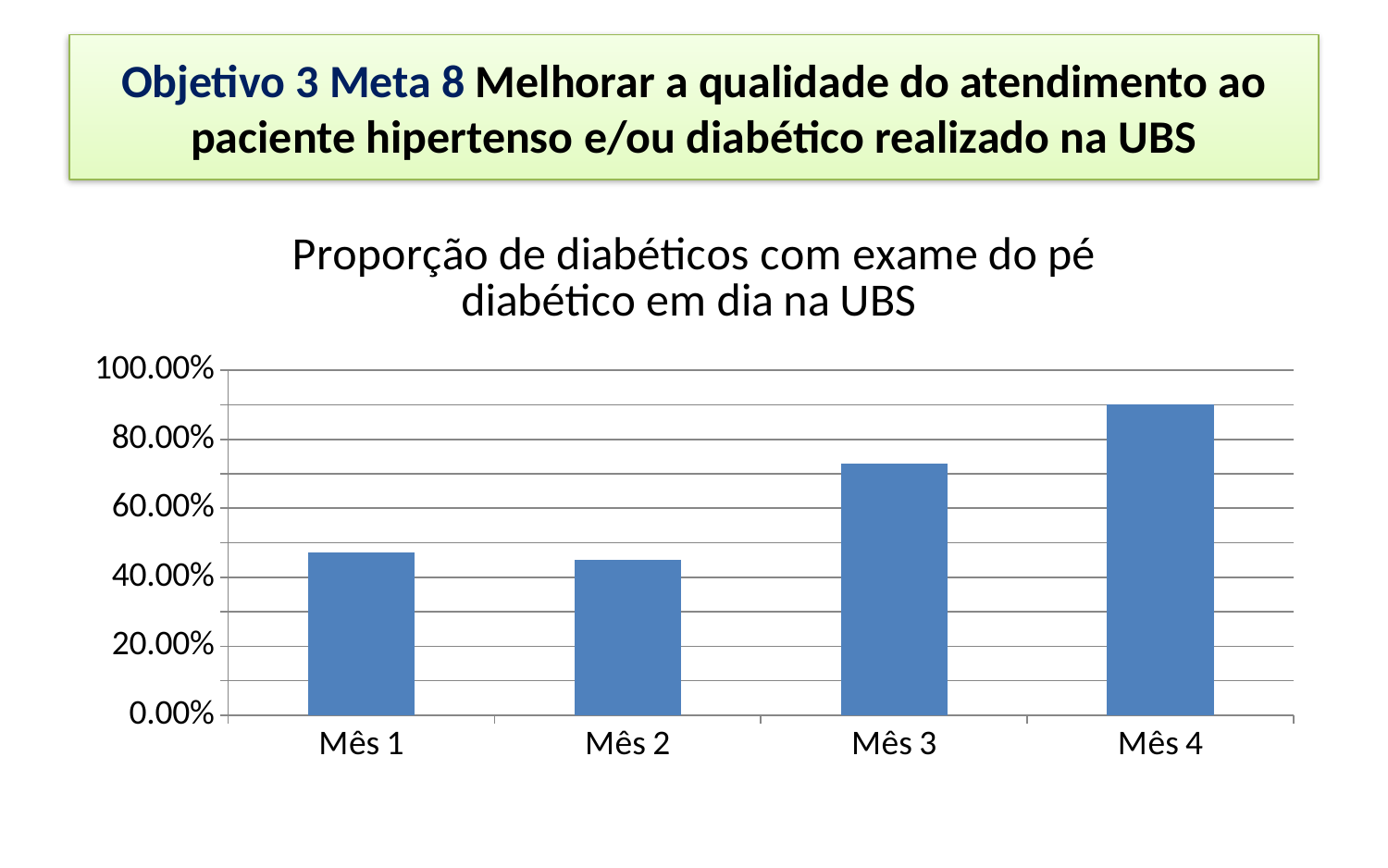
Which month has the highest value? Mês 4 Which is larger, the value for Mês 3 or the value for Mês 1? Mês 3 Is the value for Mês 4 greater or less than 80.00%? greater What is the title of the chart? Proporção de diabéticos com exame do pé diabético em dia na UBS Which is larger, the value for Mês 4 or the value for Mês 3? Mês 4 Is the value for Mês 1 greater or less than 40.00%? greater Is the value for Mês 3 greater or less than 60.00%? greater How many months (categories) are plotted on the x axis? 4 What type of chart is shown on the slide? bar chart Do the values rise or fall from Mês 2 to Mês 4? rise